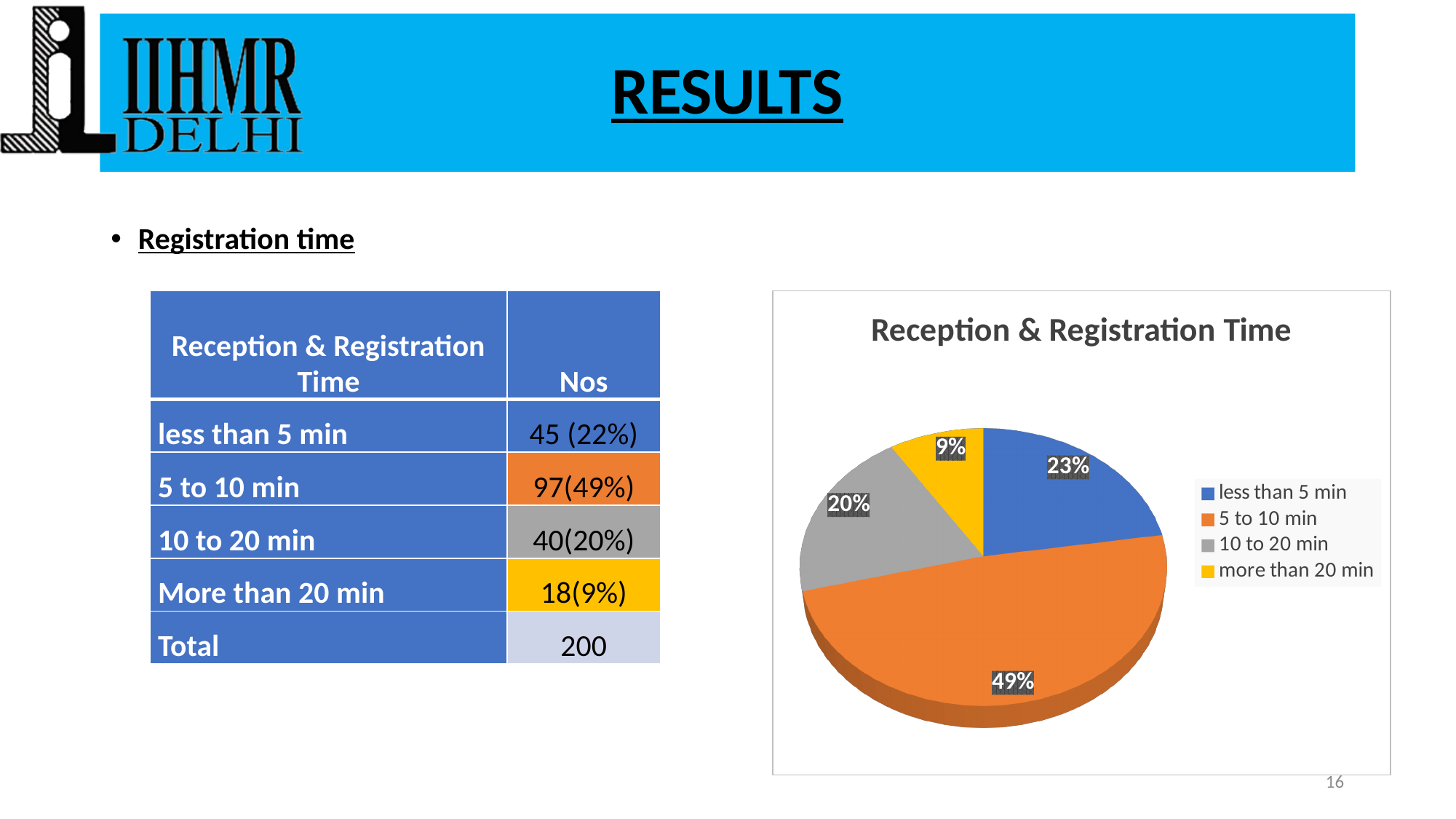
What percentage does the pie chart show for '10 to 20 min'? 20% What is the title of the chart? Reception & Registration Time What percentage does the pie chart show for '5 to 10 min'? 49% Which category has the smallest slice in the pie chart? more than 20 min What percentage does the pie chart show for 'more than 20 min'? 9% In the pie chart, which slice is larger: 'less than 5 min' or '10 to 20 min'? less than 5 min What colour is the '5 to 10 min' slice in the pie chart? orange Which category has the largest slice in the pie chart? 5 to 10 min What percentage does the pie chart show for 'less than 5 min'? 23% How many entries does the chart's legend list? 4 What type of chart is shown on the slide? pie chart How many slices does the pie chart have? 4